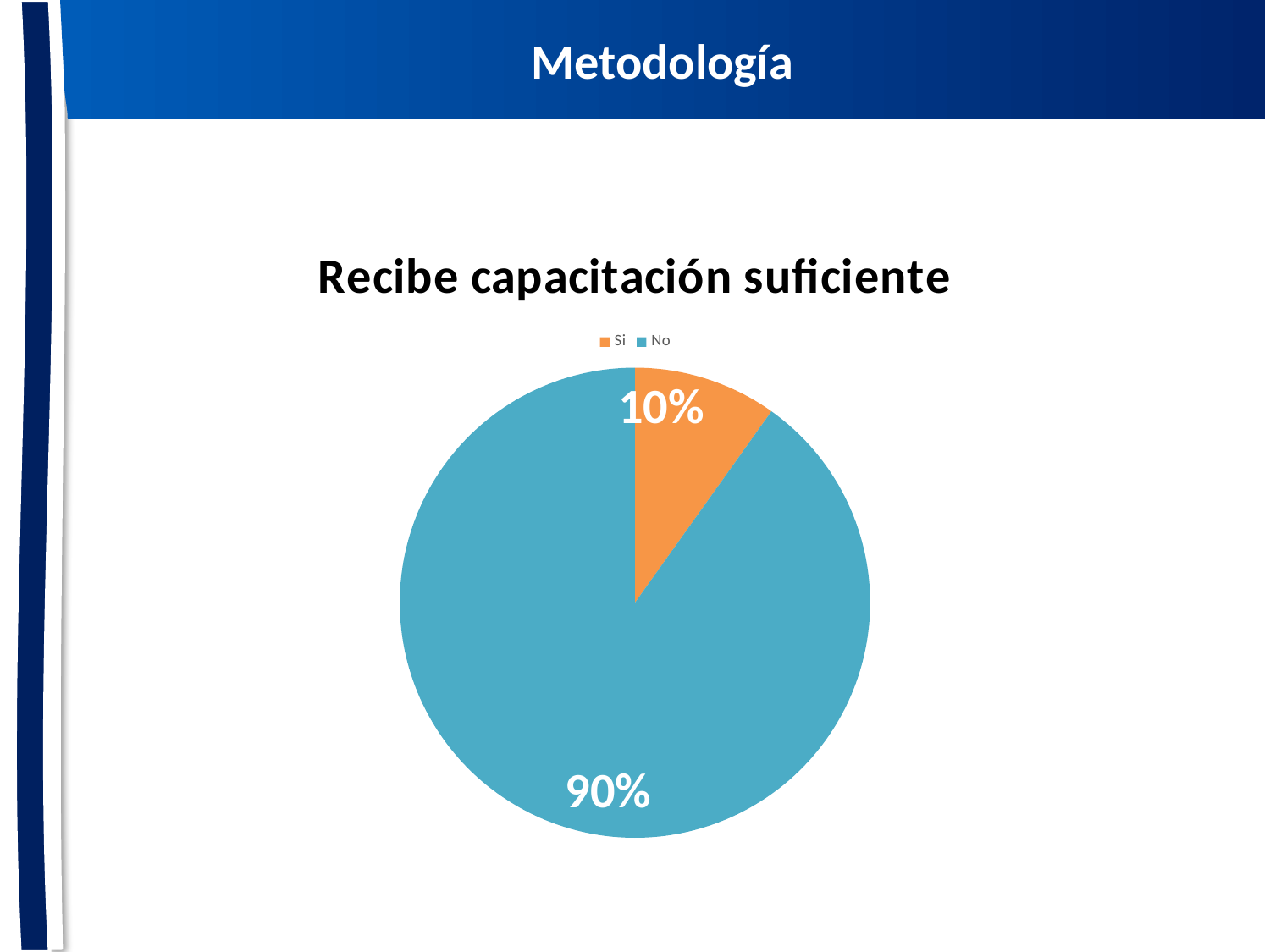
What is the title of the chart? Recibe capacitación suficiente What percentage of the pie corresponds to "No"? 90% How many entries does the legend list? 2 What share of the pie does the "No" slice represent? 90% Which category has the smallest share of the pie? Si How many categories does the pie chart show? 2 What is the difference in percentage points between the "No" and "Si" slices? 80 What percentage of the pie corresponds to "Si"? 10% What colour is the "Si" slice? orange Which slice is larger, "Si" or "No"? No What type of chart is shown on the slide? pie chart Which category has the largest share of the pie? No